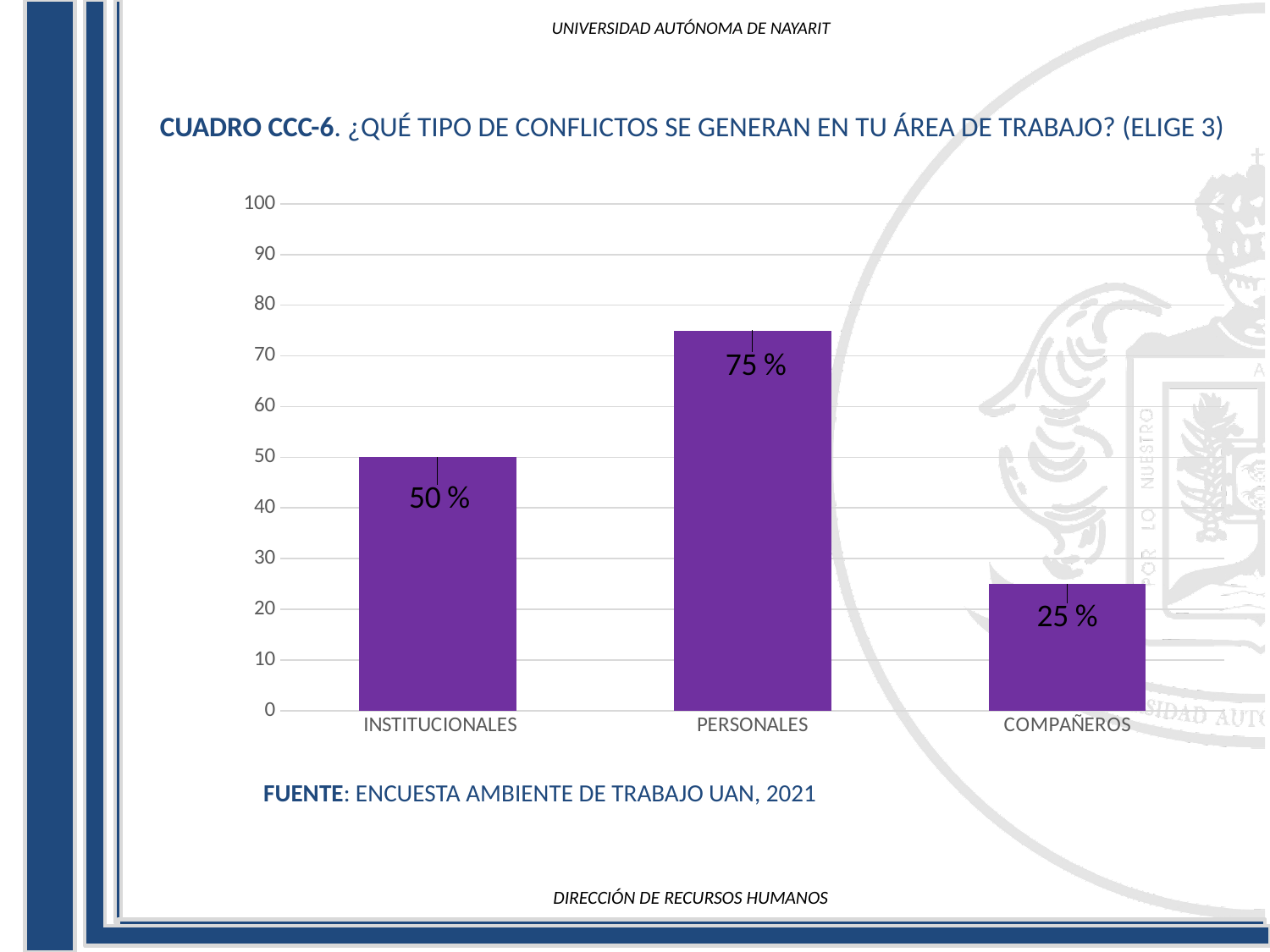
What is the value for INSTITUCIONALES? 50 % Which category has the highest value? PERSONALES What kind of chart is shown on the slide? bar chart Which category has the lowest value? COMPAÑEROS What is the value for PERSONALES? 75 % Which is larger, the value for INSTITUCIONALES or the value for COMPAÑEROS? INSTITUCIONALES What is the difference between the values for INSTITUCIONALES and COMPAÑEROS? 25 % What is the value for COMPAÑEROS? 25 % What is the difference between the values for PERSONALES and INSTITUCIONALES? 25 % How many categories are shown on the x axis? 3 What source is cited below the chart? ENCUESTA AMBIENTE DE TRABAJO UAN, 2021 Is the value for PERSONALES greater or less than 70? greater